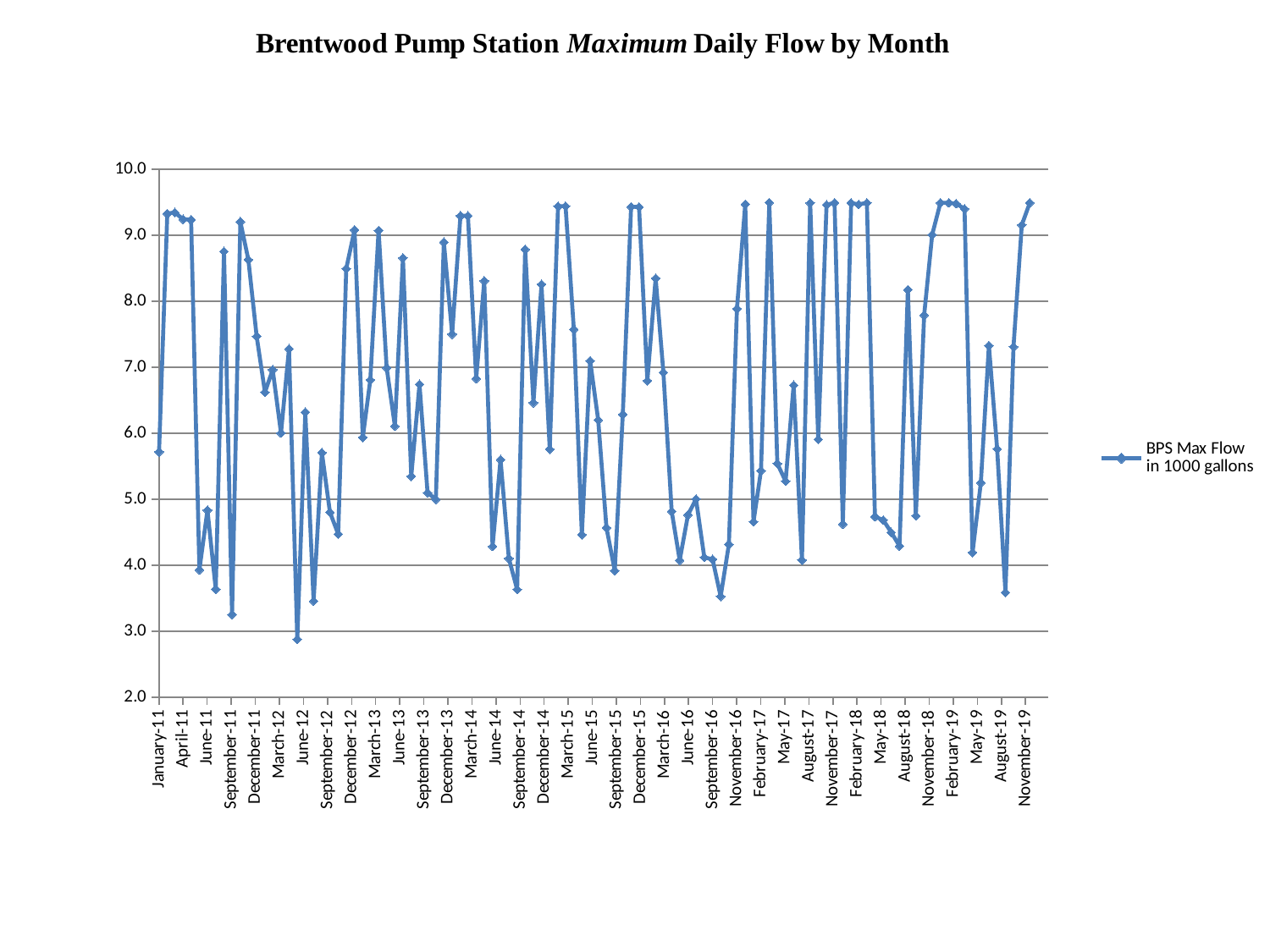
What kind of chart is shown on the slide? line chart Is the value for January-11 greater or less than 6.0? less Is the value for January-11 greater or less than 5.0? greater Is the highest value plotted on the chart greater or less than 10.0? less What is the legend entry for the plotted series? BPS Max Flow in 1000 gallons Which is larger, the value for January-11 or the value for November-19? November-19 What is the title of the chart? Brentwood Pump Station Maximum Daily Flow by Month How many series does the legend list? 1